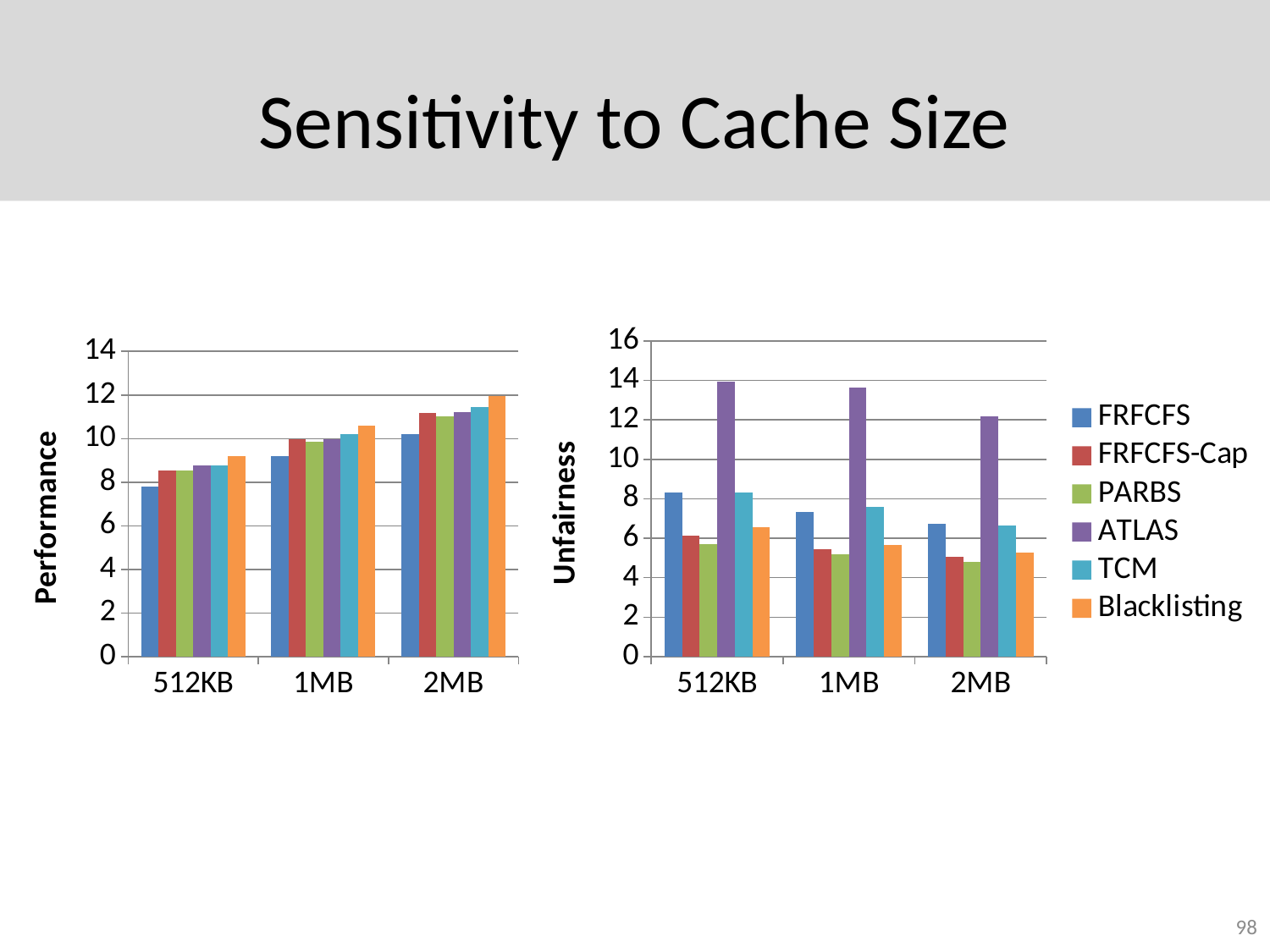
What kind of chart is the Performance chart on the left? bar chart How many cache-size categories are shown on the x axis of the Performance chart? 3 In the Performance chart, which series has the highest value at 2MB? Blacklisting In the Performance chart, do the FRFCFS values rise or fall as cache size increases from 512KB to 2MB? rise In the Unfairness chart, which series has the highest value at 512KB? ATLAS How many series does the legend list for the charts on this slide? 6 In the Performance chart, which series has the lowest value at 512KB? FRFCFS In the Unfairness chart at 1MB, which is larger: FRFCFS or FRFCFS-Cap? FRFCFS In the Unfairness chart, do the ATLAS values rise or fall as cache size increases from 512KB to 2MB? fall In the Performance chart, is the value for Blacklisting at 2MB greater or less than 10? greater In the Performance chart, is the value for FRFCFS at 512KB greater or less than 8? less In the Unfairness chart, is the value for ATLAS at 512KB greater or less than 12? greater